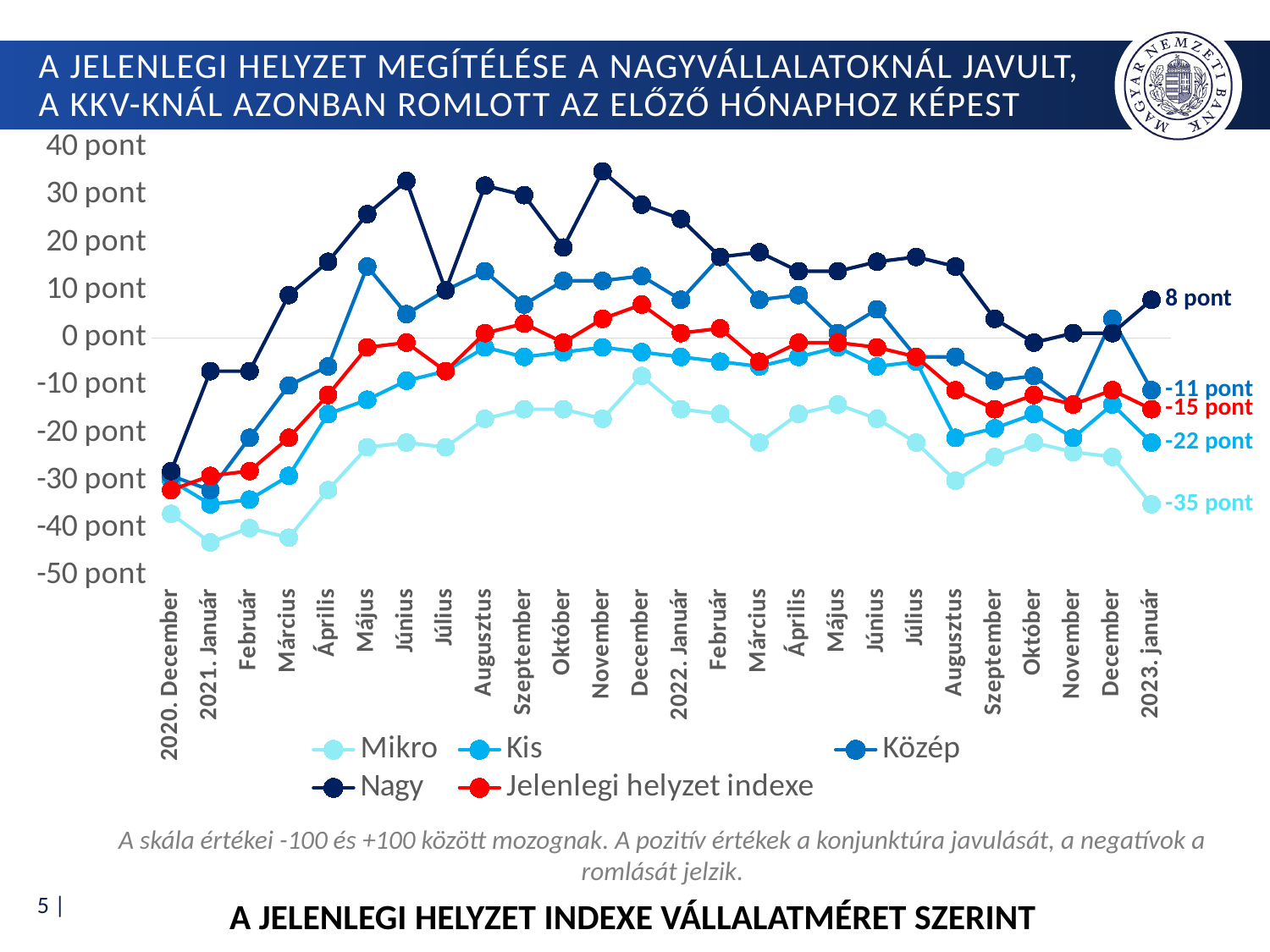
Is the value of the Nagy series in 2021 Június greater or less than 30 pont? greater What is the value of the Jelenlegi helyzet indexe series in 2023. január? -15 pont In 2023. január, which is larger: the Kis value or the Közép value? Közép What is the value of the Nagy series in 2023. január? 8 pont How many series does the legend list? 5 What is the value of the Közép series in 2023. január? -11 pont Which series has the highest value in 2023. január? Nagy What kind of chart is shown on the slide? Line chart What is the value of the Mikro series in 2023. január? -35 pont What is the value of the Kis series in 2023. január? -22 pont In 2023. január, what is the difference between the Nagy value and the Mikro value? 43 pont Is the value of the Mikro series in 2021. január greater or less than -40 pont? less